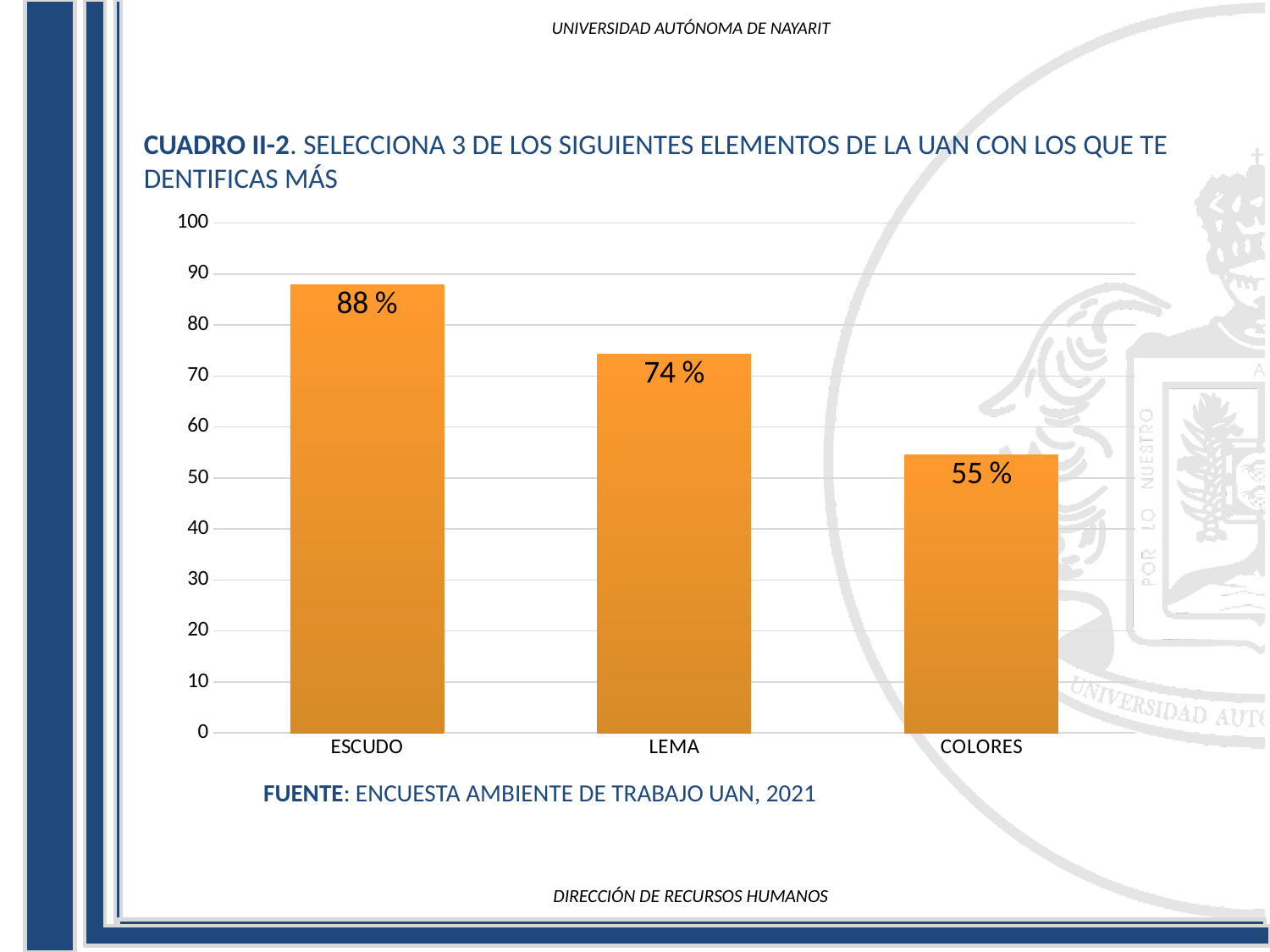
What is the value for LEMA? 74 % How many categories are shown on the x axis? 3 What is the difference between the values for LEMA and COLORES? 19 % What is the difference between the values for ESCUDO and LEMA? 14 % Is the value for COLORES greater or less than 60? less What is the value for ESCUDO? 88 % What kind of chart is shown on the slide? bar chart Which category has the highest value? ESCUDO Which is larger, the value for LEMA or the value for COLORES? LEMA Do the values rise or fall from left to right along the x axis? fall What is the value for COLORES? 55 % Which category has the lowest value? COLORES